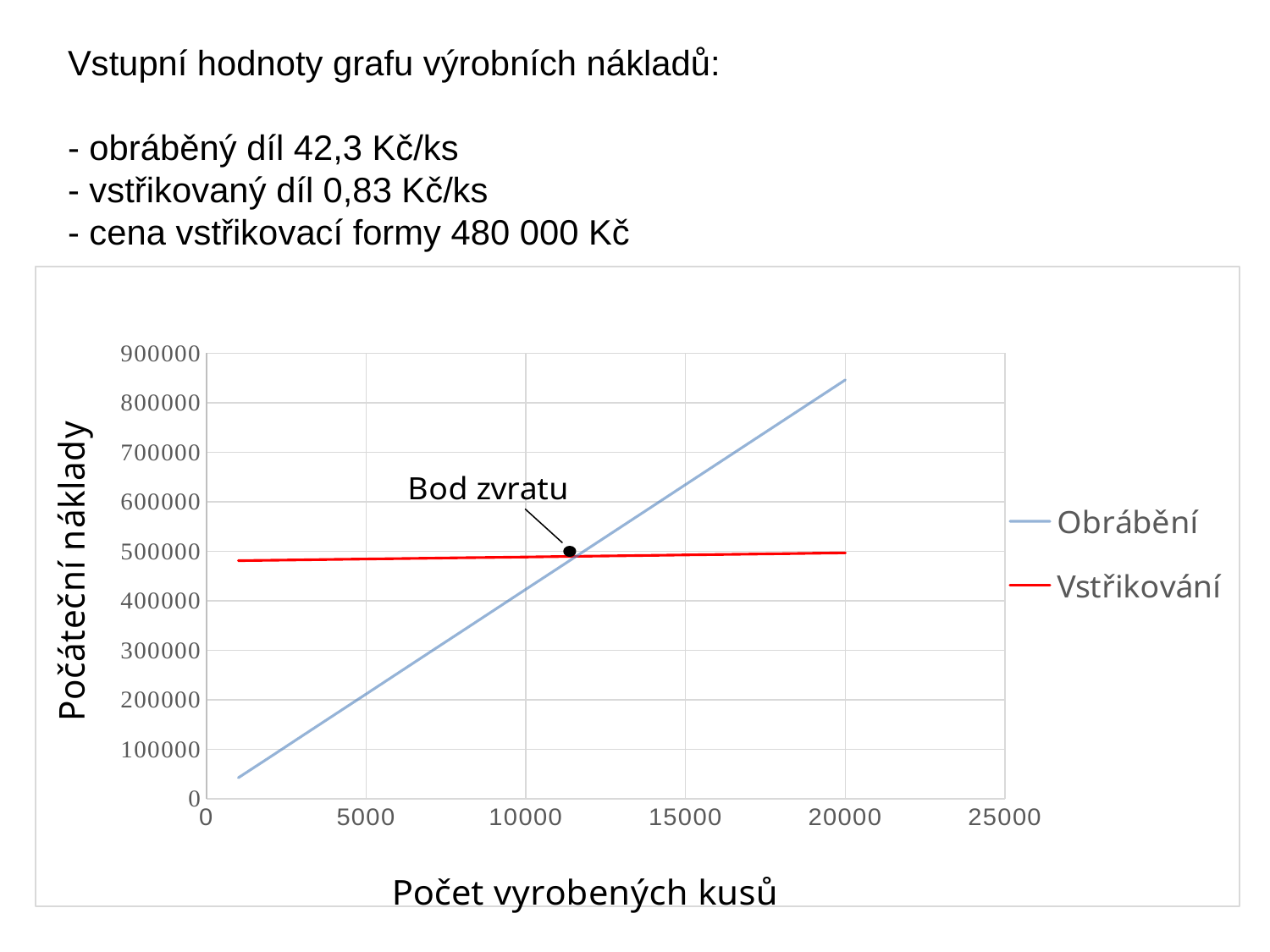
At 20000 pieces, which series has the higher cost, Obrábění or Vstřikování? Obrábění Is the value of the Obrábění line at 10000 pieces greater or less than 500000? less Is the value of the Obrábění line at 20000 pieces greater or less than 800000? greater Is the value of the Vstřikování line at 5000 pieces greater or less than 400000? greater How many series does the chart legend list? 2 What kind of chart is shown on the slide? line chart Does the Obrábění line rise or fall as the number of produced pieces increases? rise At 5000 pieces, which series has the higher cost, Obrábění or Vstřikování? Vstřikování What label is attached to the marked point where the two lines cross? Bod zvratu Which two series are listed in the chart legend? Obrábění and Vstřikování